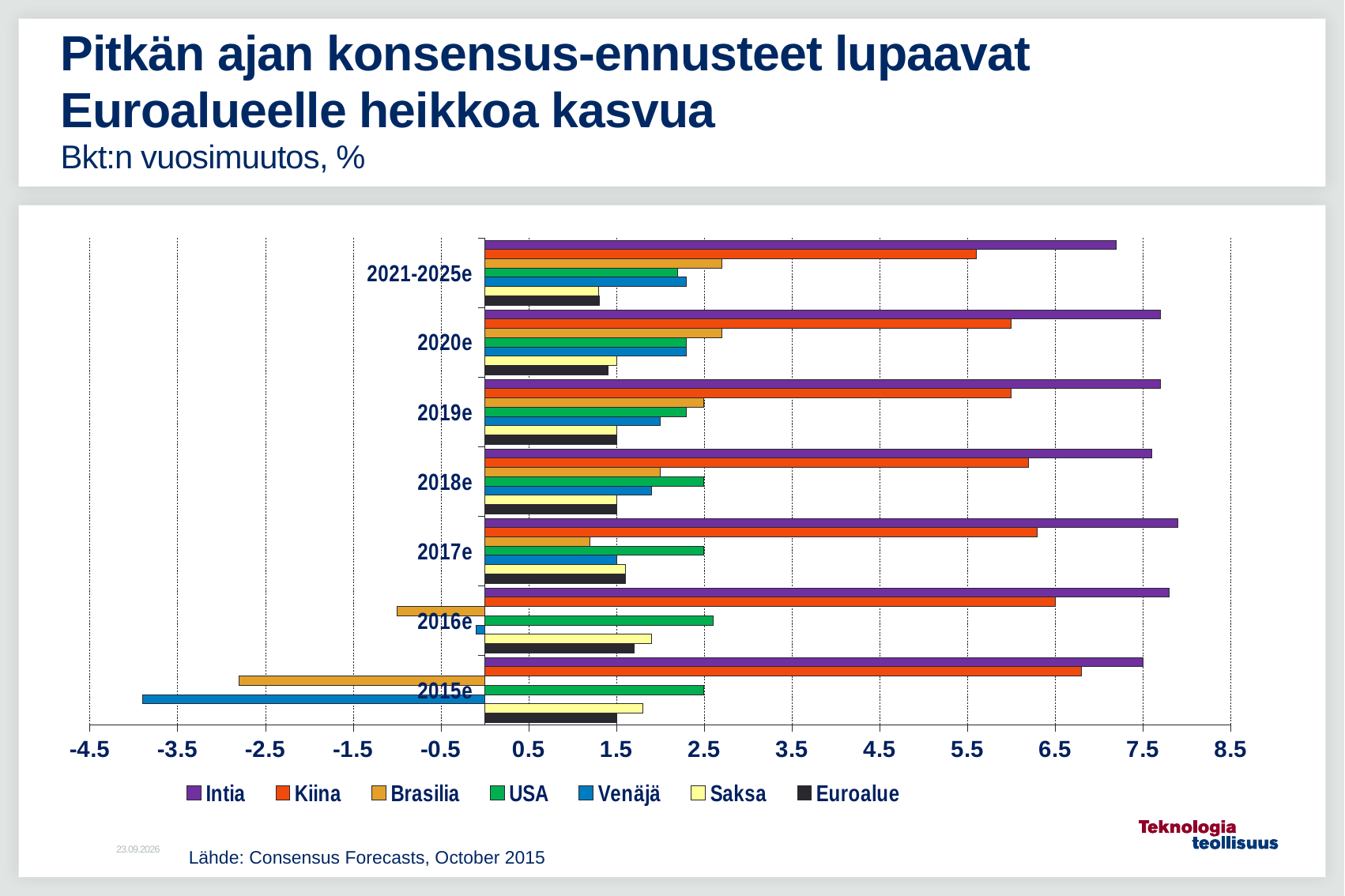
Does the value for Venäjä rise or fall from 2015e to 2017e? rise Is the value for Intia in 2017e greater or less than 7.5? greater Which country or region has the highest value for 2015e? Intia Is the value for Brasilia in 2015e greater or less than -2.5? less Is the value for Intia in 2021-2025e greater or less than 7.5? less How many period categories are shown on the vertical axis? 7 How many series does the legend list? 7 What source is cited below the chart? Consensus Forecasts, October 2015 What kind of chart is shown on the slide? bar chart Which is larger in 2020e, the value for Intia or the value for Kiina? Intia Which country or region has the lowest value for 2015e? Venäjä